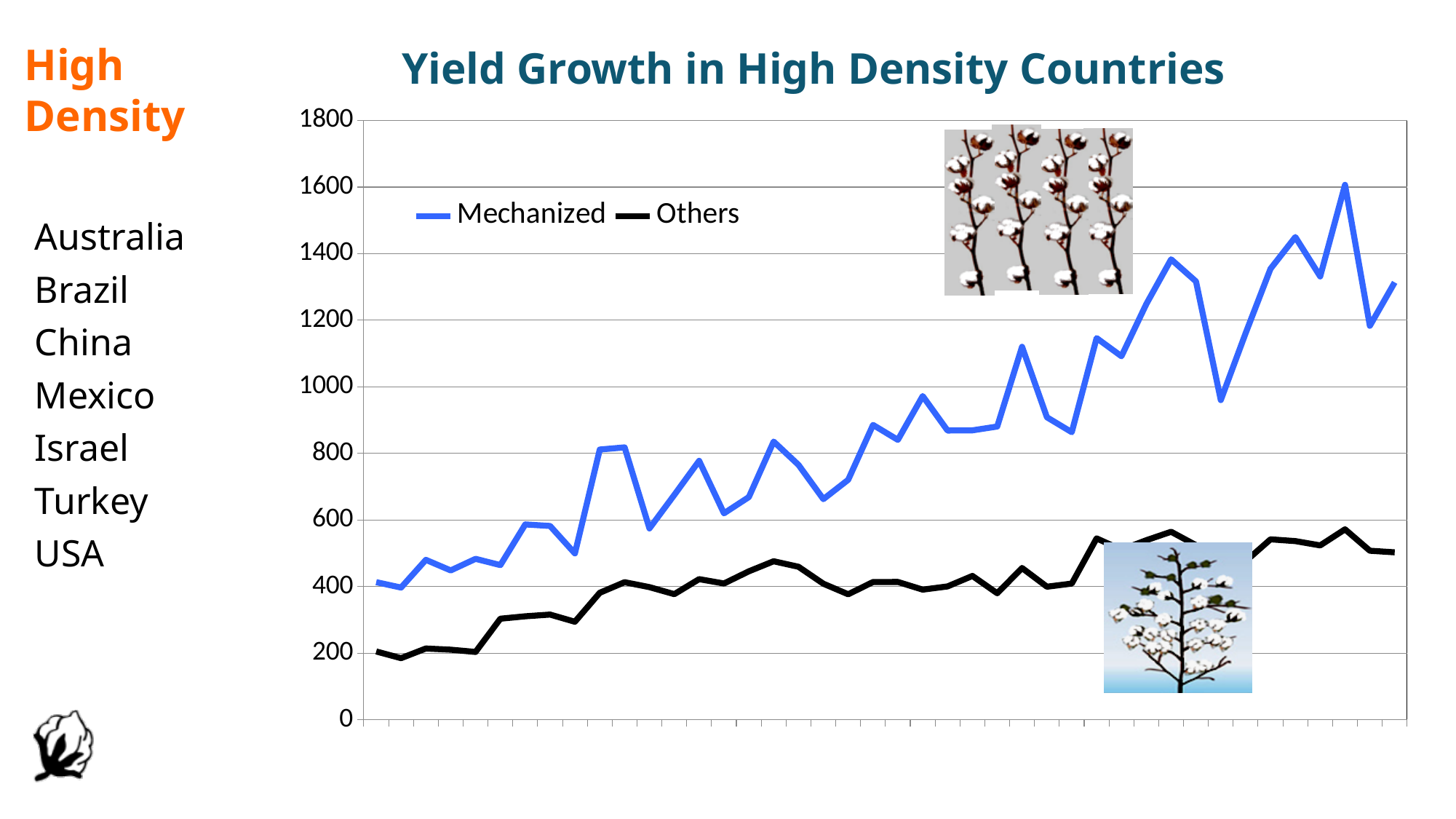
Is the highest point of the Mechanized line greater or less than 1400? greater Is the highest point of the Others line greater or less than 800? less Is the last point of the Mechanized line greater or less than 1000? greater Does the Mechanized line generally rise or fall from left to right? rise Does the Others line generally rise or fall from left to right? rise What are the two series named in the chart's legend? Mechanized and Others What is the highest value shown on the chart's vertical axis? 1800 What is the title of the chart? Yield Growth in High Density Countries What kind of chart is shown on the slide? line chart Which series is plotted higher across the whole chart, Mechanized or Others? Mechanized How many series does the chart's legend list? 2